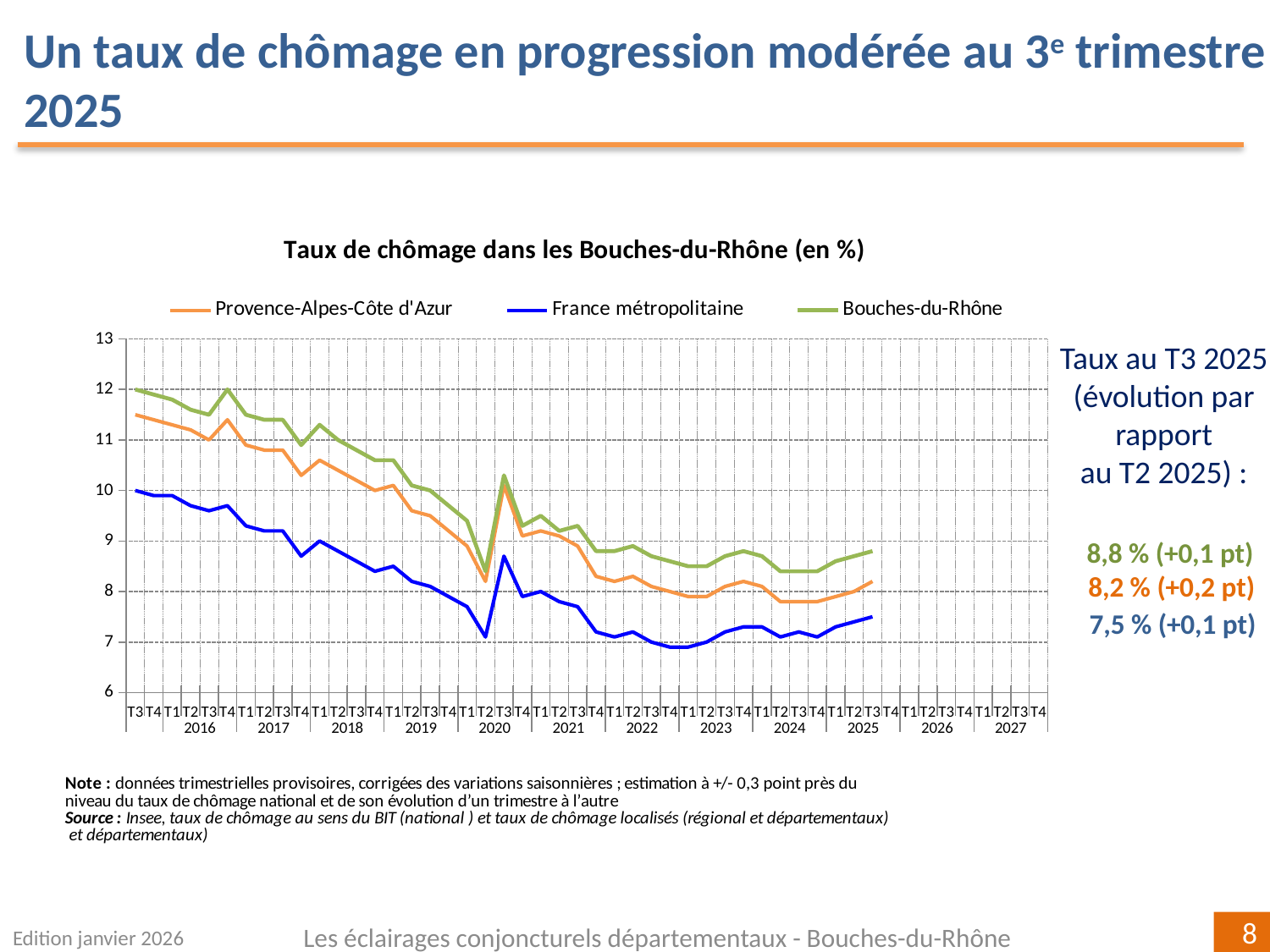
Overall, does the France métropolitaine line rise or fall between 2016 and 2025? Fall How many series does the legend of the chart list? 3 What is the title of the chart? Taux de chômage dans les Bouches-du-Rhône (en %) What kind of chart is shown on the slide? Line chart By how much did the Provence-Alpes-Côte d'Azur rate change between T2 2025 and T3 2025? +0,2 pt At T3 2025, which is higher: the rate for Provence-Alpes-Côte d'Azur or for France métropolitaine? Provence-Alpes-Côte d'Azur Which series has the highest value at T3 2025? Bouches-du-Rhône What is the unemployment rate for Provence-Alpes-Côte d'Azur at T3 2025? 8,2 % What is the unemployment rate for Bouches-du-Rhône at T3 2025? 8,8 % What is the difference between the Bouches-du-Rhône rate and the France métropolitaine rate at T3 2025? 1,3 points Is the value for France métropolitaine at T1 2016 greater or less than 9? greater What is the unemployment rate for France métropolitaine at T3 2025? 7,5 %